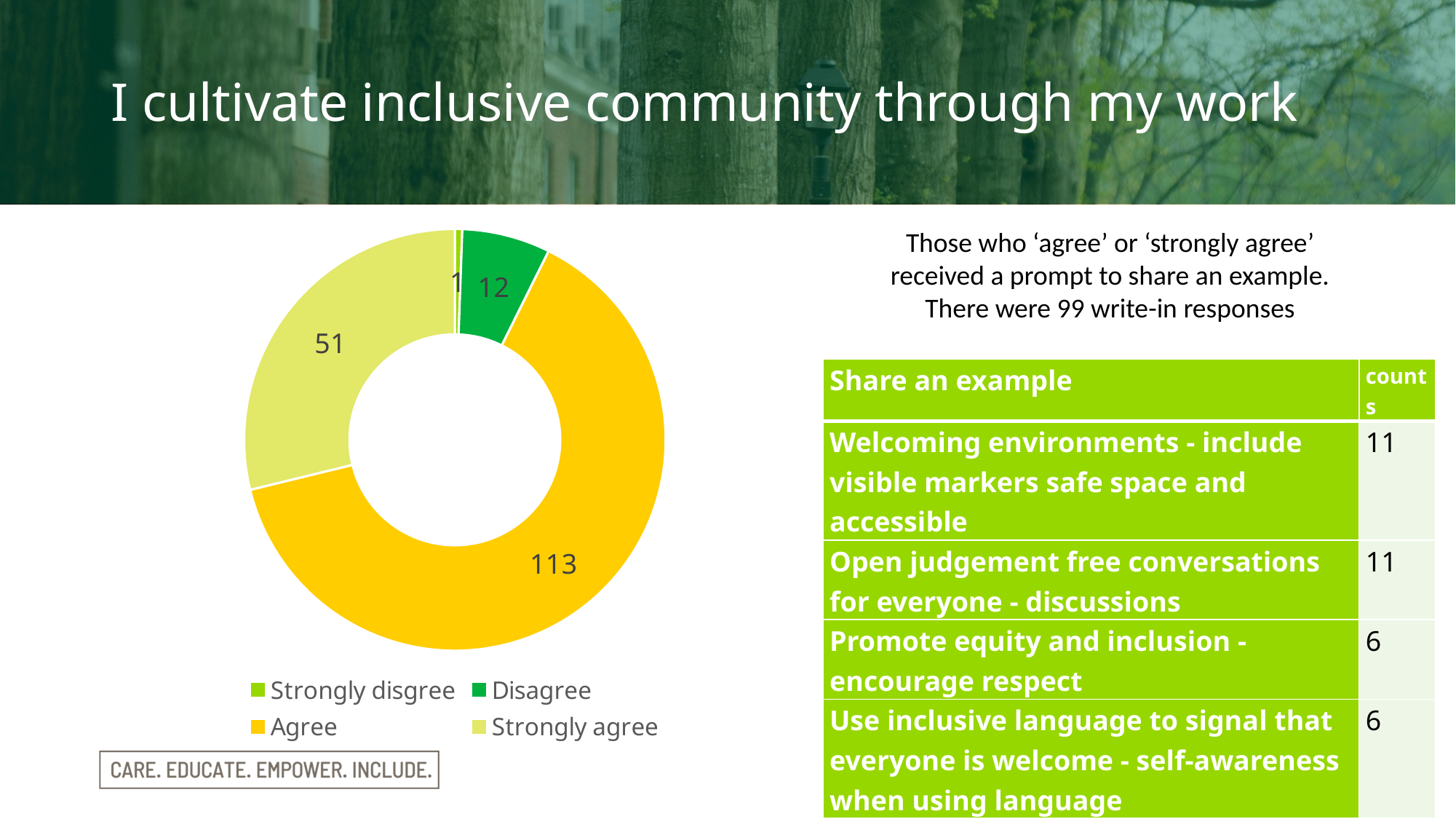
What kind of chart is shown on the slide? doughnut chart What is the difference between the 'Agree' and 'Strongly agree' values in the chart? 62 Which response category has the smallest value in the chart? Strongly disgree How many response categories does the chart's legend list? 4 What is the value shown for 'Strongly disgree' in the chart? 1 What is the value shown for 'Disagree' in the chart? 12 How many respondents selected 'Agree' in the doughnut chart? 113 What colour is the 'Agree' segment in the chart? yellow What is the difference between the 'Disagree' and 'Strongly disgree' values in the chart? 11 What is the value shown for 'Strongly agree' in the chart? 51 Which response category has the largest value in the chart? Agree Which is larger in the chart, 'Strongly agree' or 'Disagree'? Strongly agree